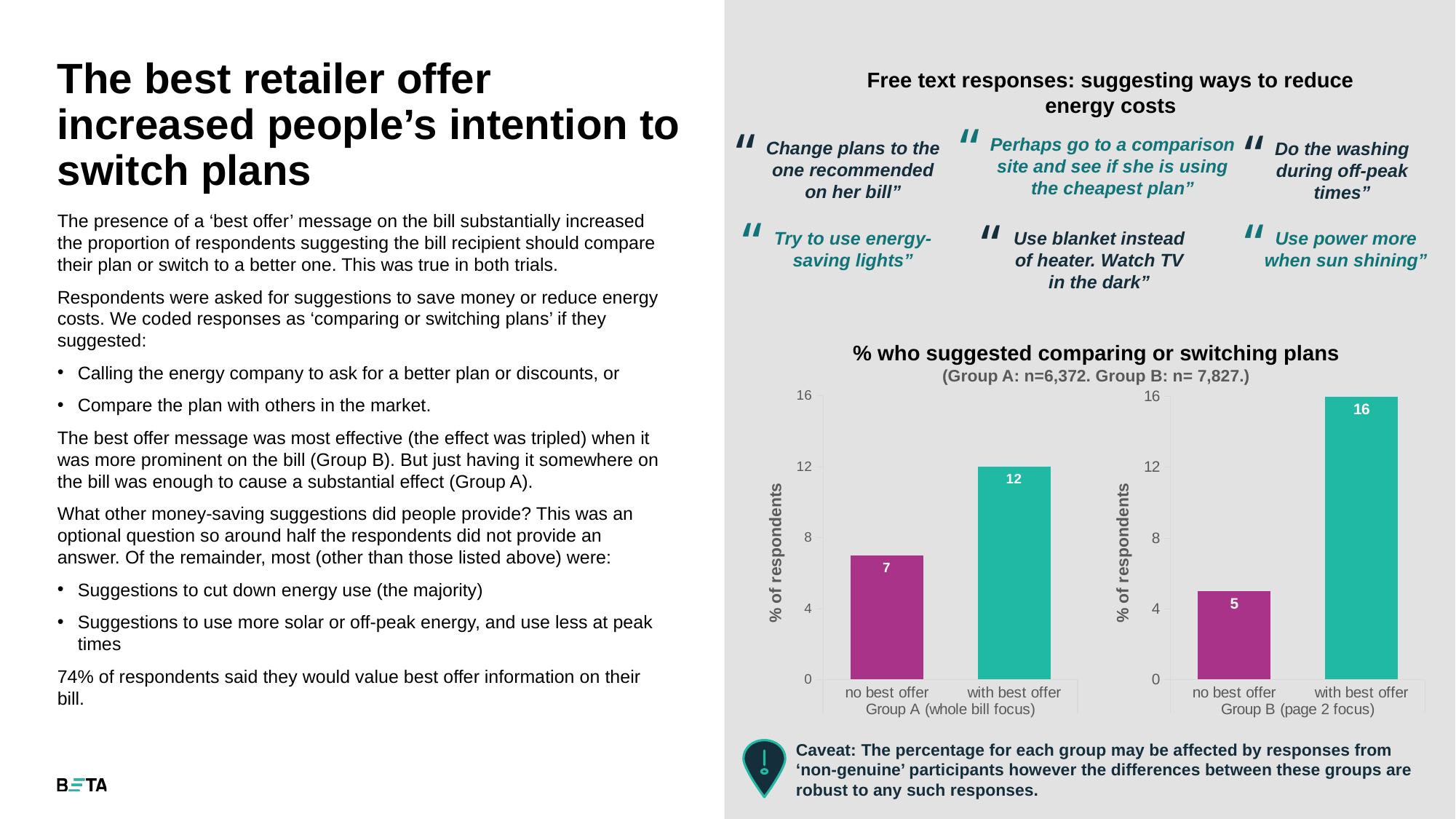
In the Group B (page 2 focus) chart, which category has the highest value? with best offer In the Group A (whole bill focus) chart, what is the value for 'no best offer'? 7 In the Group A (whole bill focus) chart, what is the value for 'with best offer'? 12 How many bars are in the Group A (whole bill focus) chart? 2 In the Group B (page 2 focus) chart, what is the value for 'with best offer'? 16 What type of chart is used for the Group B (page 2 focus) data? bar chart In the Group B (page 2 focus) chart, what is the difference between 'with best offer' and 'no best offer'? 11 What is the y-axis label on the Group A (whole bill focus) chart? % of respondents In the Group A (whole bill focus) chart, which category has the lowest value? no best offer Which is larger: 'with best offer' in the Group A chart or 'with best offer' in the Group B chart? with best offer in Group B In the Group A (whole bill focus) chart, what is the difference between 'with best offer' and 'no best offer'? 5 In the Group B (page 2 focus) chart, what is the value for 'no best offer'? 5